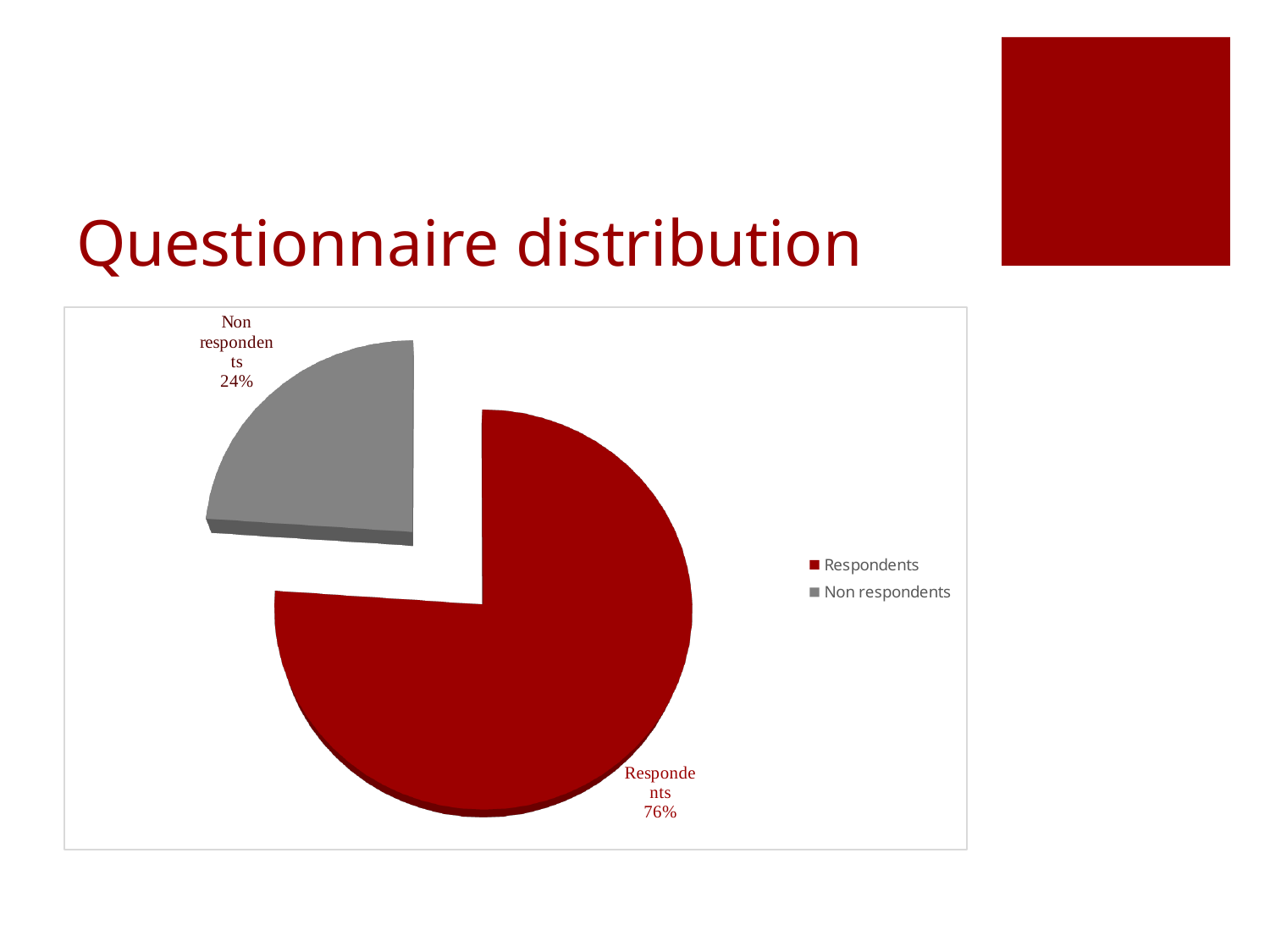
What is the difference in percentage points between Respondents and Non respondents? 52 How many entries does the legend list? 2 What is the title of the slide containing the pie chart? Questionnaire distribution Which slice of the pie is the smallest? Non respondents What share of the pie is Respondents? 76% Which slice of the pie is the largest? Respondents Which is larger, the Respondents slice or the Non respondents slice? Respondents How many slices does the pie chart have? 2 What share of the pie is Non respondents? 24% What kind of chart is shown on the slide? pie chart What colour is the Non respondents slice? grey